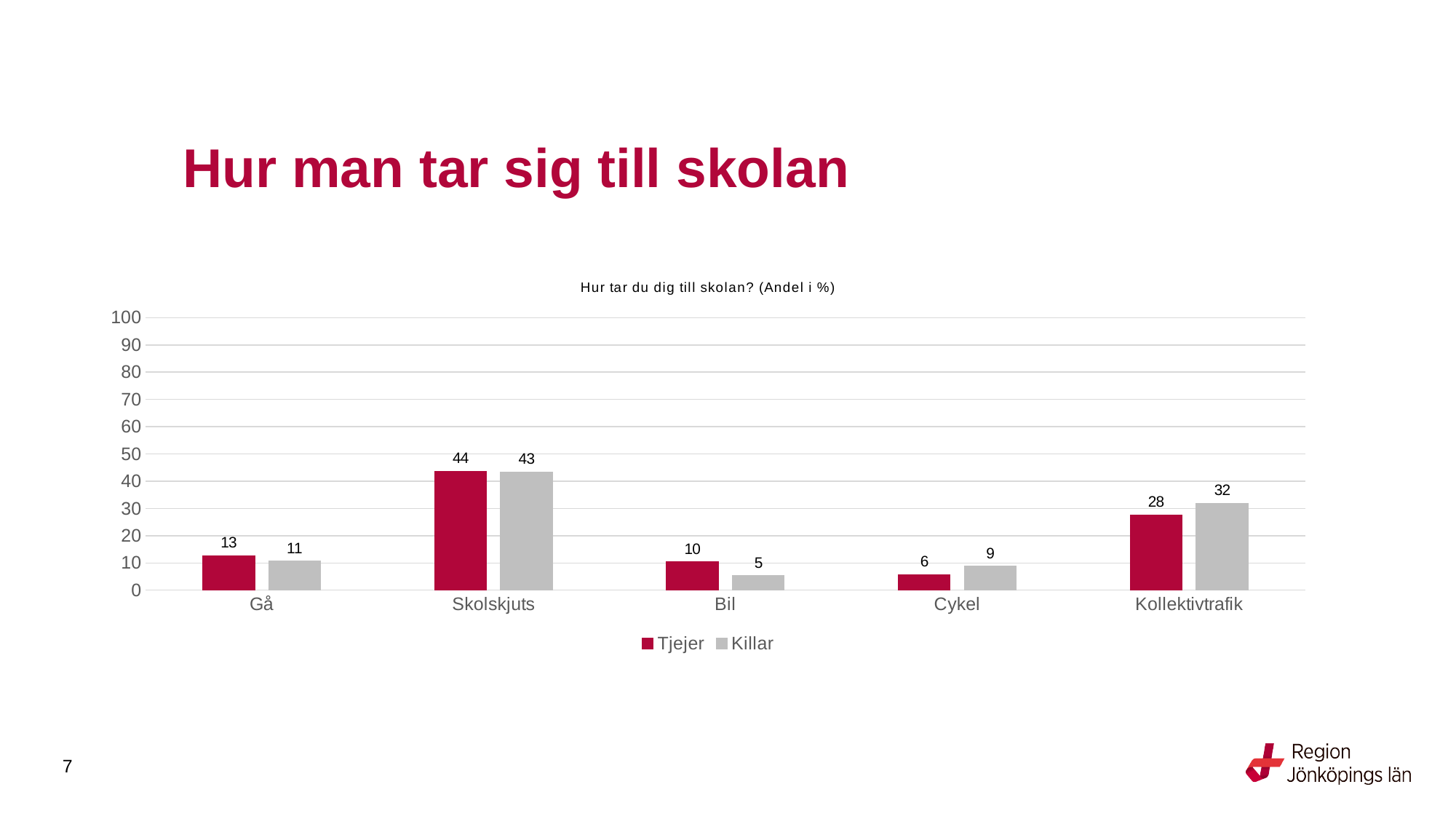
How many categories are shown on the x axis? 5 What is the title of the chart? Hur tar du dig till skolan? (Andel i %) Which is larger for Cykel, the Tjejer value or the Killar value? Killar What is the difference between the Killar and Tjejer values for Kollektivtrafik? 4 What is the value for Killar in the Bil category? 5 Which category has the lowest value for Killar? Bil What is the difference between the Tjejer and Killar values for Bil? 5 What is the value for Killar in the Kollektivtrafik category? 32 What kind of chart is shown on the slide? Bar chart Which category has the highest value for Tjejer? Skolskjuts How many series does the legend list? 2 What is the value for Tjejer in the Skolskjuts category? 44